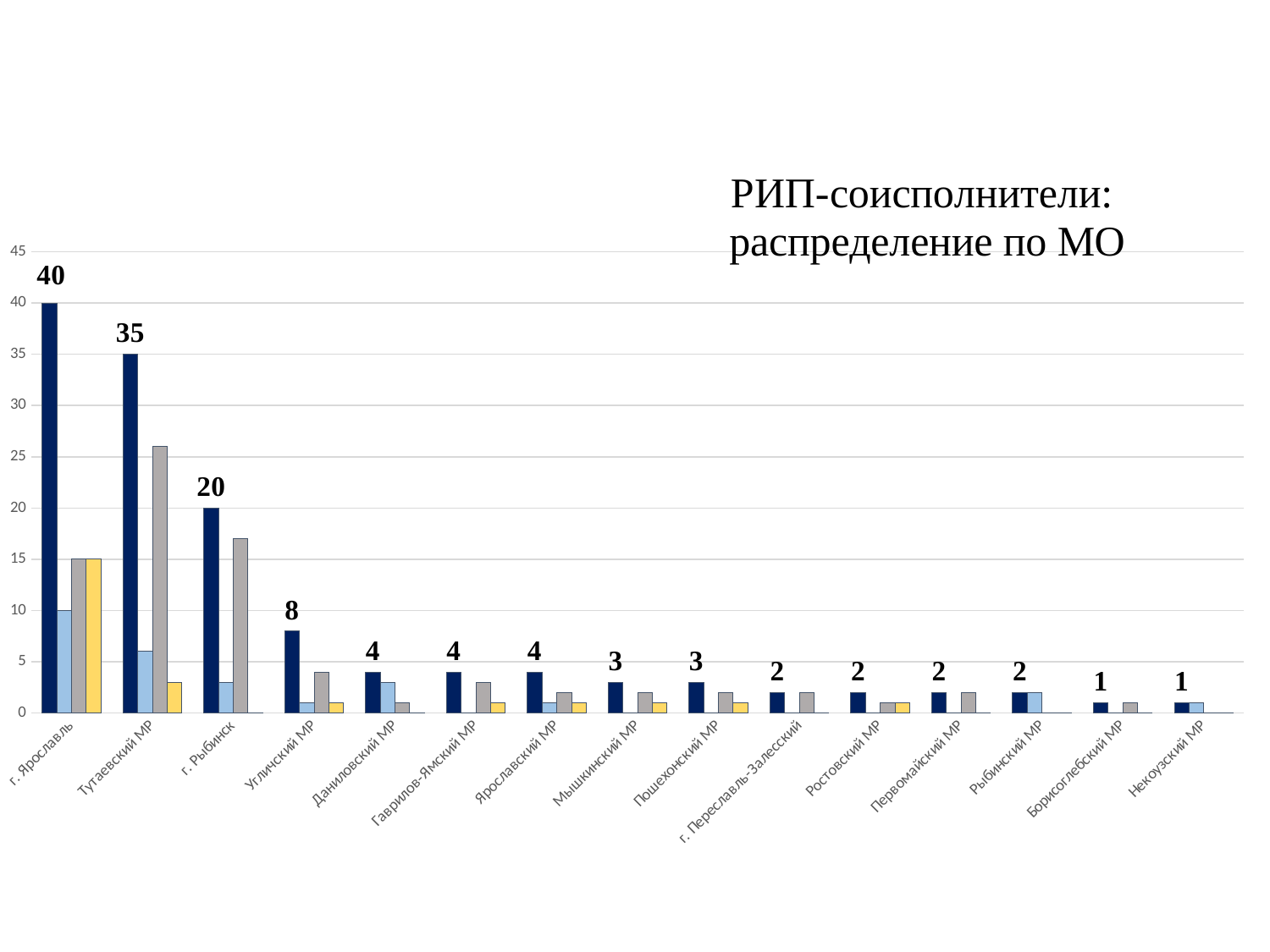
Which category has the highest labelled value? г. Ярославль How many categories are shown on the x axis? 15 Do the labelled values rise or fall from left to right along the x axis? fall What is the labelled value for г. Ярославль? 40 What kind of chart is shown on the slide? bar chart Which has the larger labelled value, г. Рыбинск or Угличский МР? г. Рыбинск What is the labelled value for Тутаевский МР? 35 What is the difference between the labelled values for г. Ярославль and Тутаевский МР? 5 What is the labelled value for Угличский МР? 8 Is the light blue bar for г. Ярославль greater or less than 5? greater What is the labelled value for Мышкинский МР? 3 Is the grey bar for г. Рыбинск greater or less than 15? greater